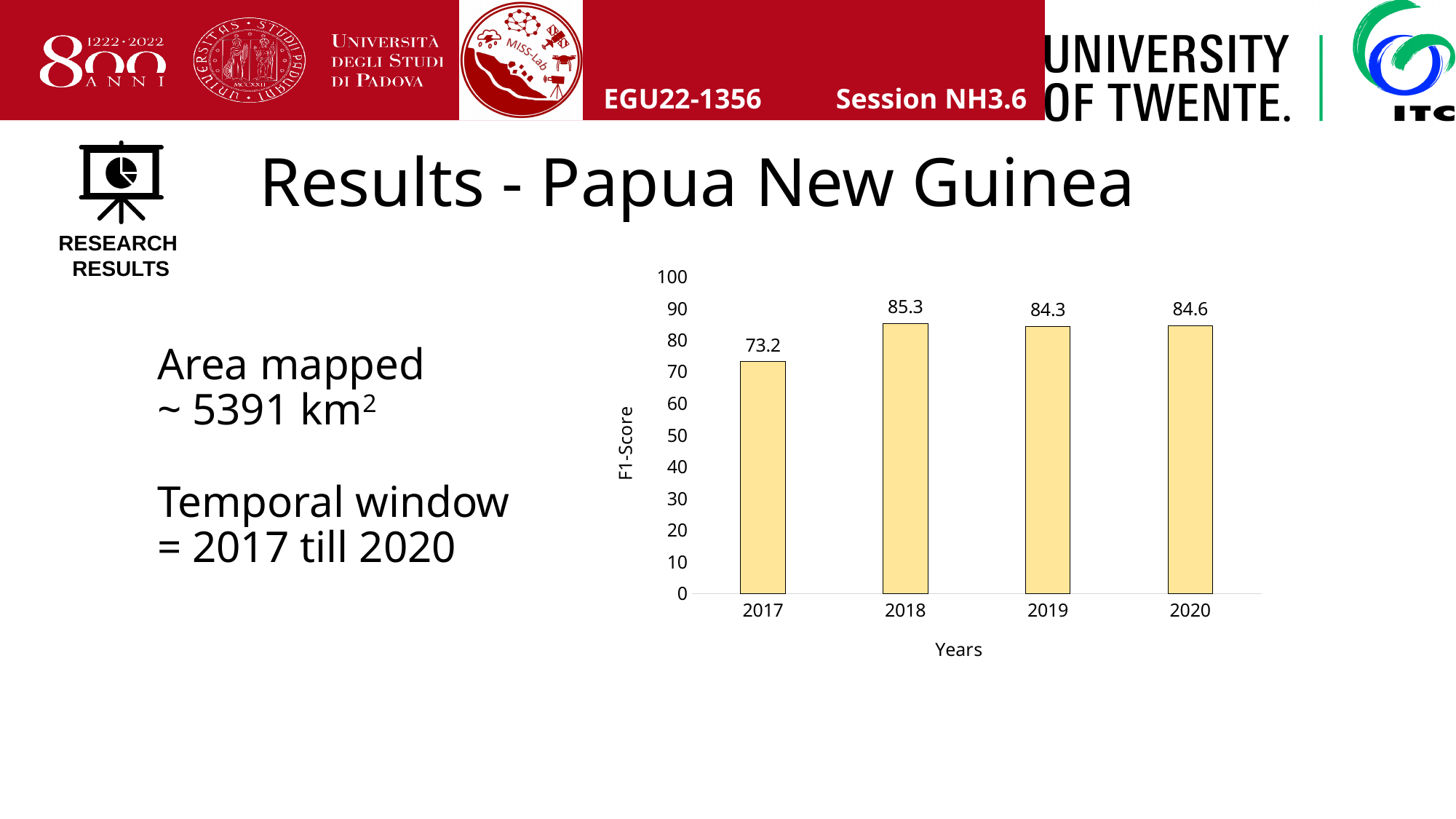
Which year has the lowest F1-Score? 2017 What kind of chart is shown on the slide? bar chart What is the F1-Score for 2017? 73.2 Which year has a higher F1-Score, 2017 or 2019? 2019 Which year has the highest F1-Score? 2018 What is the difference between the F1-Score for 2018 and the F1-Score for 2017? 12.1 How many years are shown on the x axis of the chart? 4 What is the F1-Score for 2020? 84.6 What is the F1-Score for 2018? 85.3 What is the F1-Score for 2019? 84.3 What is the label of the y axis of the chart? F1-Score Is the F1-Score for 2017 greater or less than 80? less